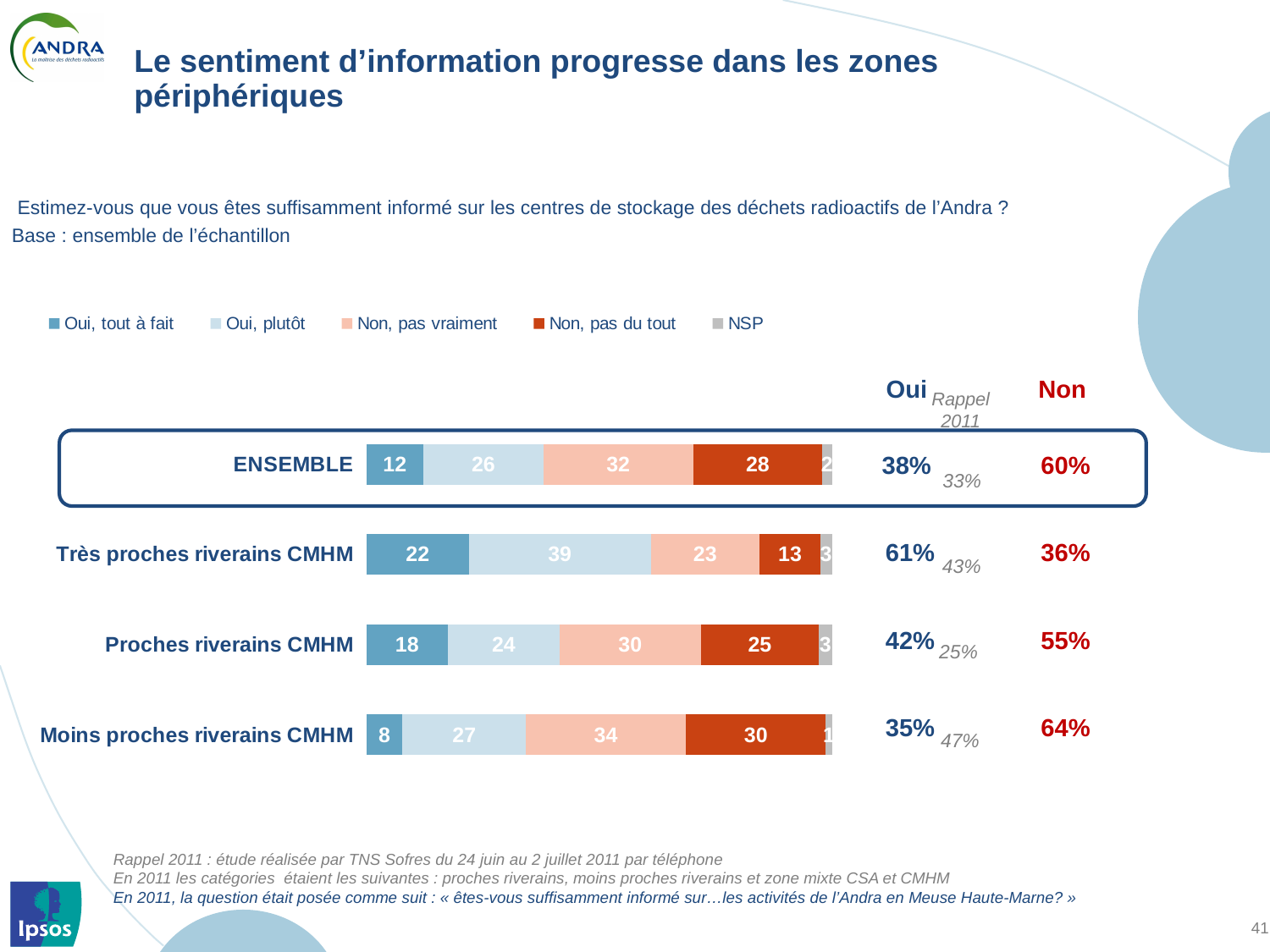
What is the total "Oui" percentage shown for Proches riverains CMHM? 42% What is the "Rappel 2011" value shown for ENSEMBLE? 33% Which category has the lowest value for "Oui, tout à fait"? Moins proches riverains CMHM Which category has the highest value for "Oui, tout à fait"? Très proches riverains CMHM How many series does the legend list? 5 What is the value of "Non, pas vraiment" for ENSEMBLE? 32 What is the value of "Oui, plutôt" for Très proches riverains CMHM? 39 What is the difference between the "Non, pas du tout" values for Moins proches riverains CMHM and Très proches riverains CMHM? 17 How many categories are plotted in the chart? 4 Which is larger: the "Oui, plutôt" value for Proches riverains CMHM or for Moins proches riverains CMHM? Moins proches riverains CMHM What is the value of "Non, pas du tout" for Moins proches riverains CMHM? 30 What kind of chart is shown on the slide? stacked bar chart